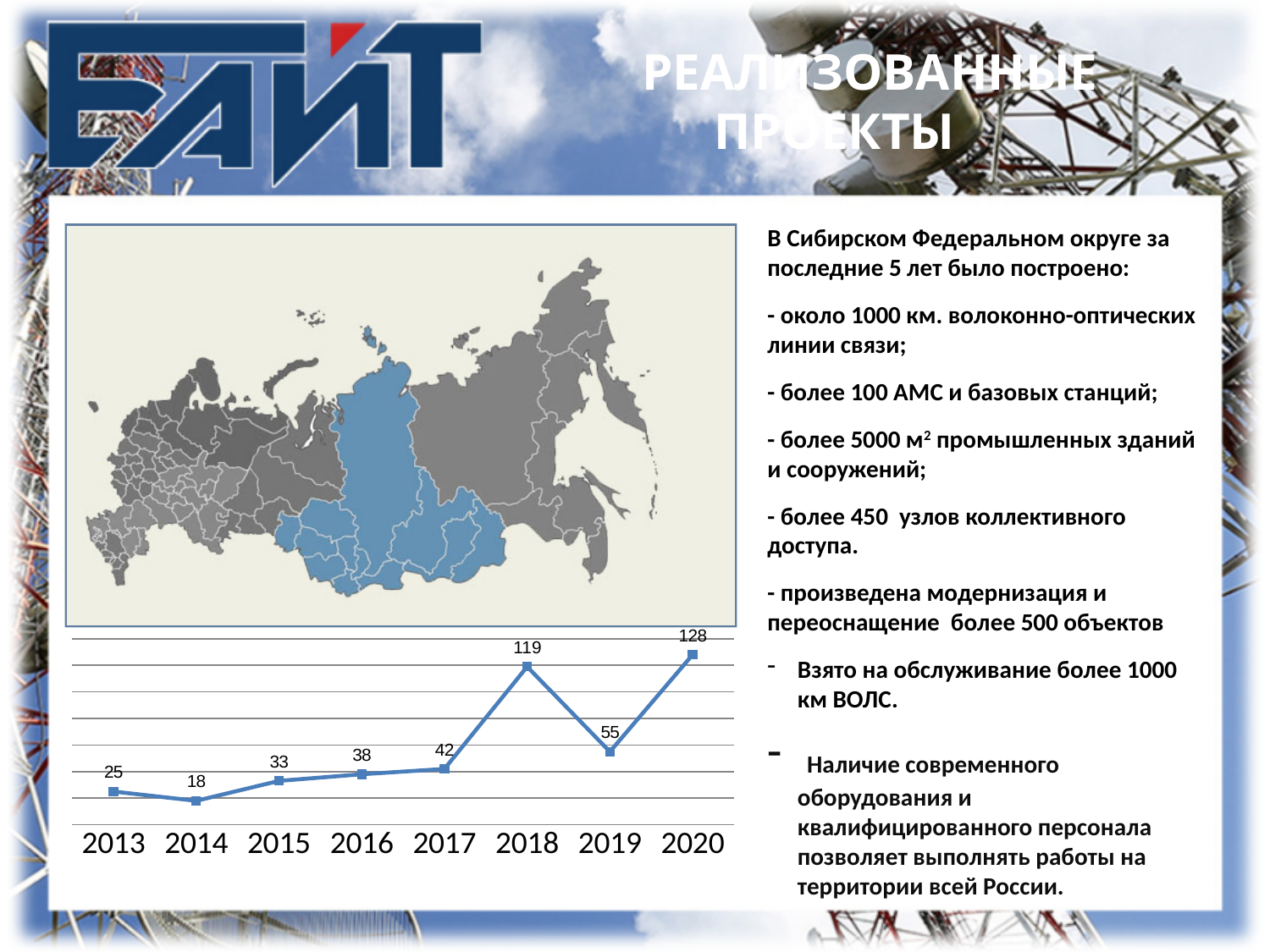
What kind of chart is shown below the map? line chart Which year has the lowest value on the line chart? 2014 Does the value on the line chart rise or fall from 2014 to 2018? rise Does the value on the line chart rise or fall from 2018 to 2019? fall Which is larger on the line chart, the value for 2015 or the value for 2016? 2016 Which year has the highest value on the line chart? 2020 What is the value for 2013 on the line chart? 25 What is the value for 2018 on the line chart? 119 What is the value for 2019 on the line chart? 55 What is the difference between the values for 2018 and 2017 on the line chart? 77 How many years are plotted on the line chart? 8 What is the difference between the values for 2020 and 2019 on the line chart? 73